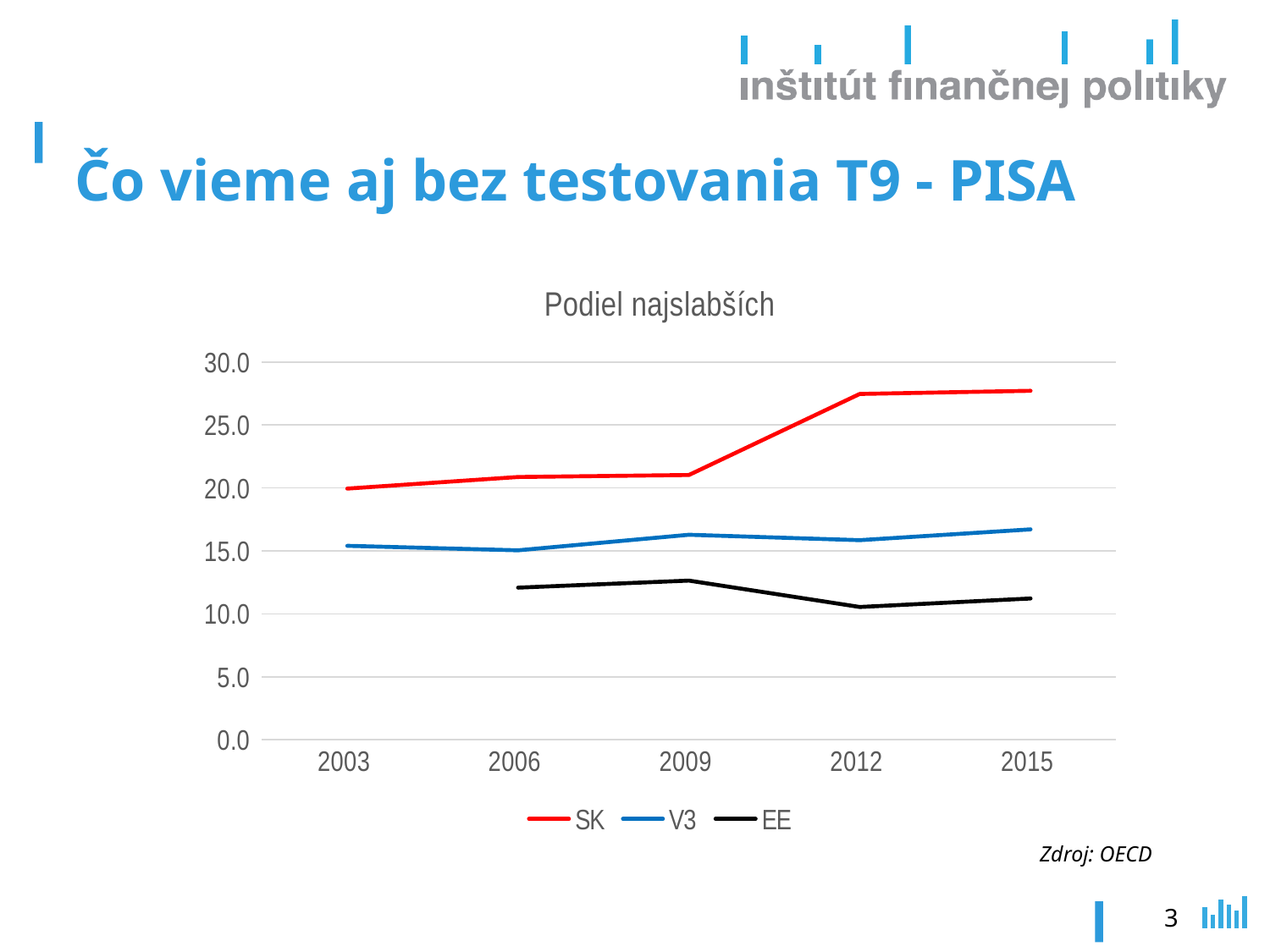
Is the value for EE in 2009 greater or less than 10.0? greater What kind of chart is shown on the slide? line chart Which is larger in 2009, the value for SK or the value for V3? SK Is the value for SK in 2015 greater or less than 25.0? greater How many series does the legend list? 3 Is the value for SK in 2003 greater or less than 25.0? less How many years are shown on the x axis? 5 Which series has the lowest value in 2012? EE Which series has the highest value in 2015? SK What is the title of the chart? Podiel najslabších Does the SK line rise or fall from 2003 to 2015? rise